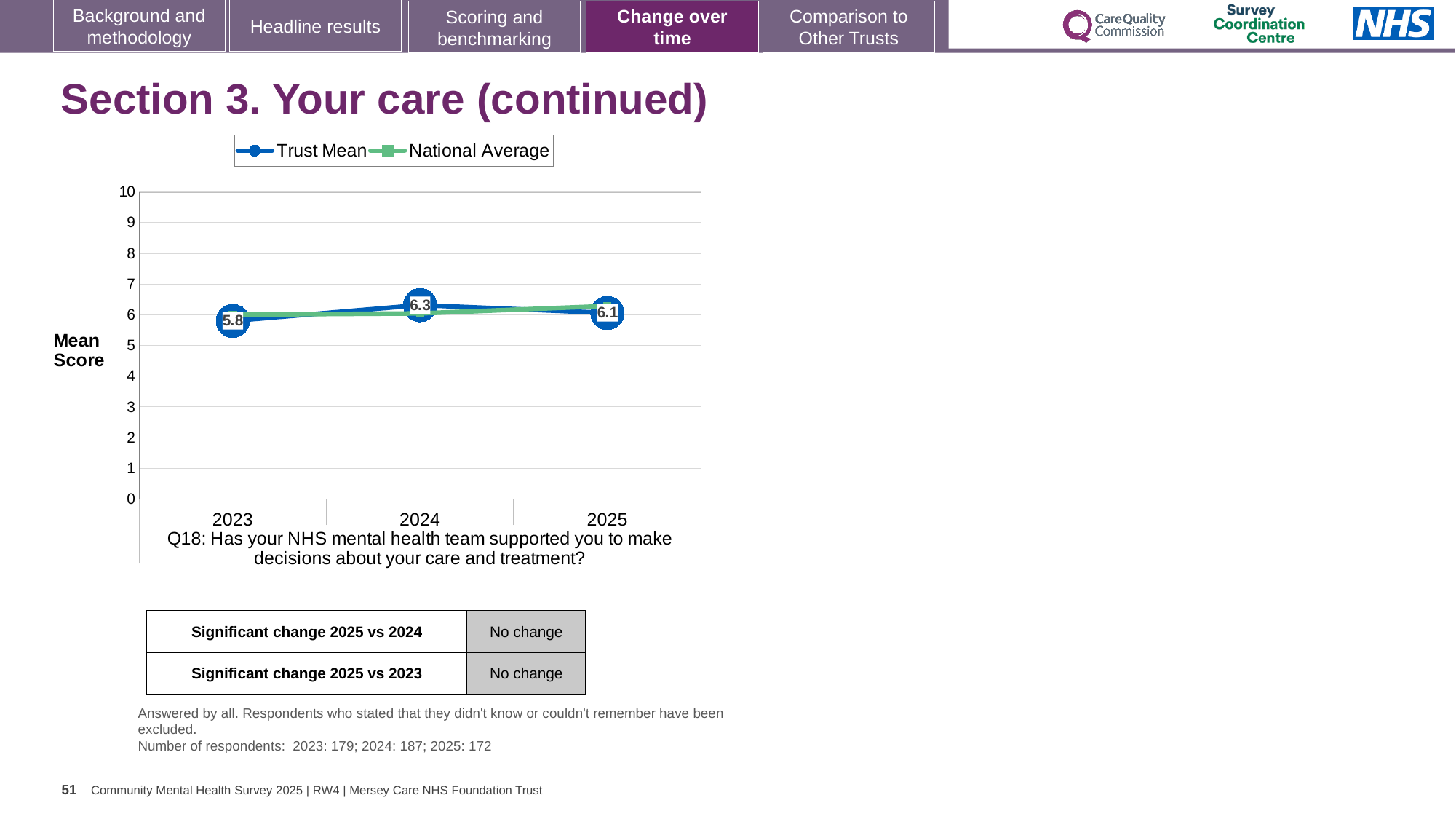
What kind of chart is shown on the slide? Line chart Is the National Average value for 2023 greater or less than 5? greater What is the Trust Mean value for 2024? 6.3 How many series does the legend list? 2 Which year has the larger Trust Mean, 2023 or 2025? 2025 What is the Trust Mean value for 2025? 6.1 Did the Trust Mean rise or fall from 2023 to 2024? Rise What is the difference between the Trust Mean in 2024 and in 2023? 0.5 What is the Trust Mean value for 2023? 5.8 In which year is the Trust Mean highest? 2024 How many years are plotted on the x axis? 3 In which year is the Trust Mean lowest? 2023